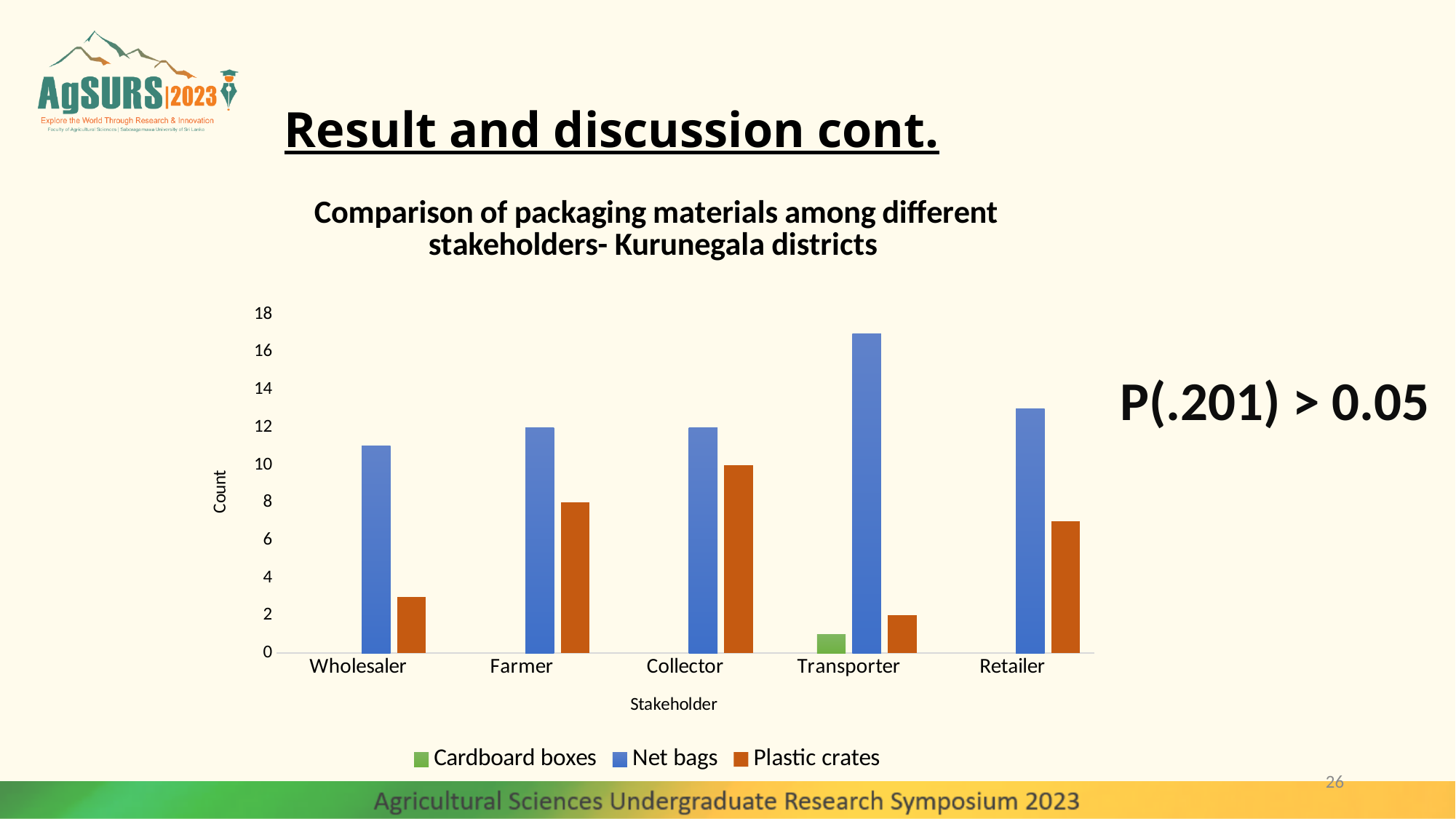
Which stakeholder has the highest count for Net bags? Transporter What is the count of Plastic crates for Collector? 10 How many stakeholder categories are shown on the x axis? 5 What kind of chart is shown on the slide? bar chart Which is larger for Retailer, Net bags or Plastic crates? Net bags Is the value for Net bags for Transporter greater or less than 16? greater Is the value for Plastic crates for Wholesaler greater or less than 4? less Which stakeholder has the lowest count for Plastic crates? Transporter How many series does the legend list? 3 What is the count of Plastic crates for Transporter? 2 Which stakeholder is the only one with a Cardboard boxes bar? Transporter What is the count of Plastic crates for Farmer? 8